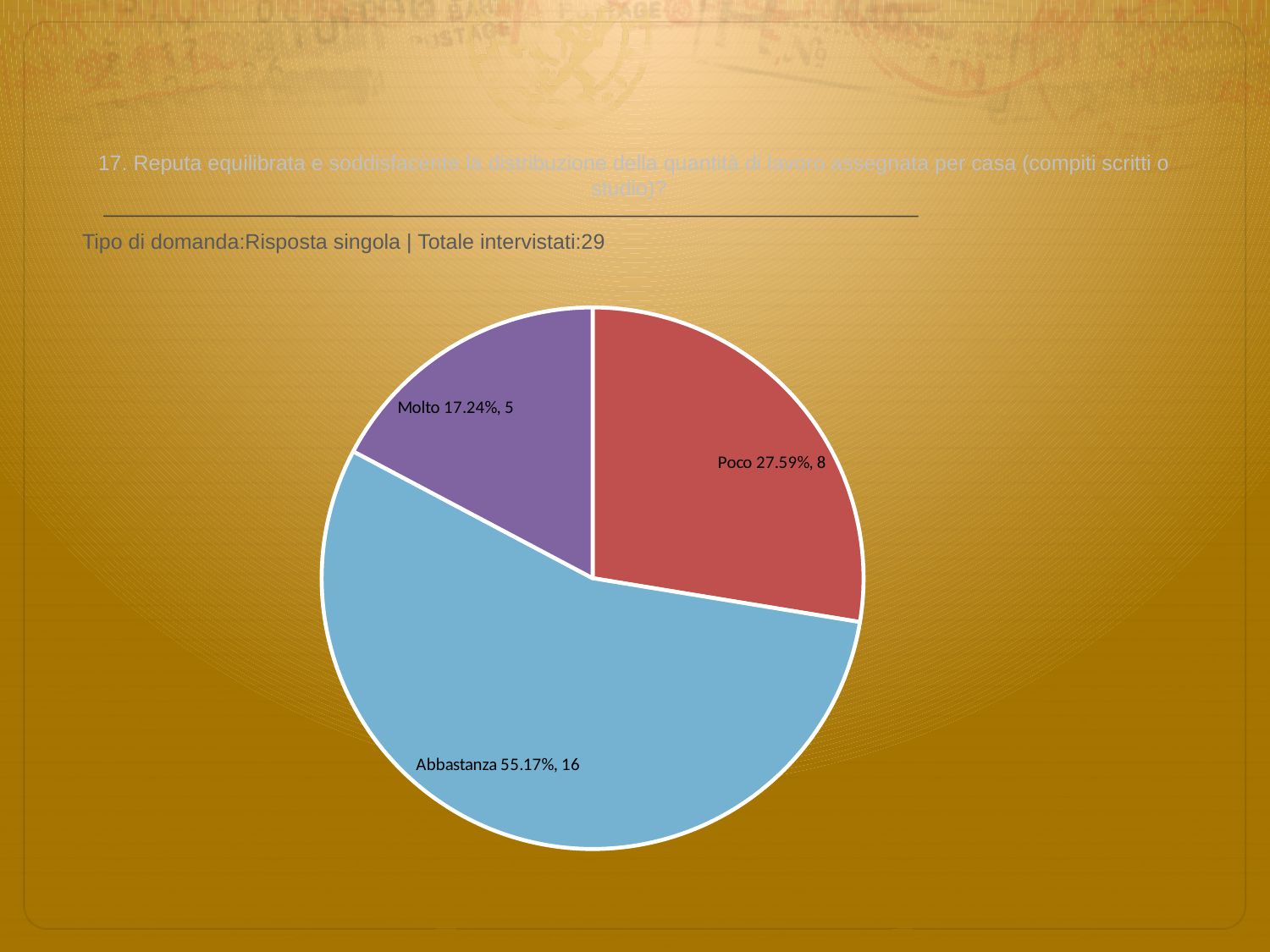
How many respondents chose Abbastanza? 16 How many slices does the pie chart have? 3 What is the difference in respondent count between Abbastanza and Poco? 8 How many respondents chose Poco? 8 Which category has the smallest slice? Molto What percentage share does the Molto slice have? 17.24% What percentage share does the Abbastanza slice have? 55.17% What kind of chart is shown on the slide? pie chart How many respondents chose Molto? 5 What percentage share does the Poco slice have? 27.59% Which category has the largest slice? Abbastanza Which slice is larger, Poco or Molto? Poco